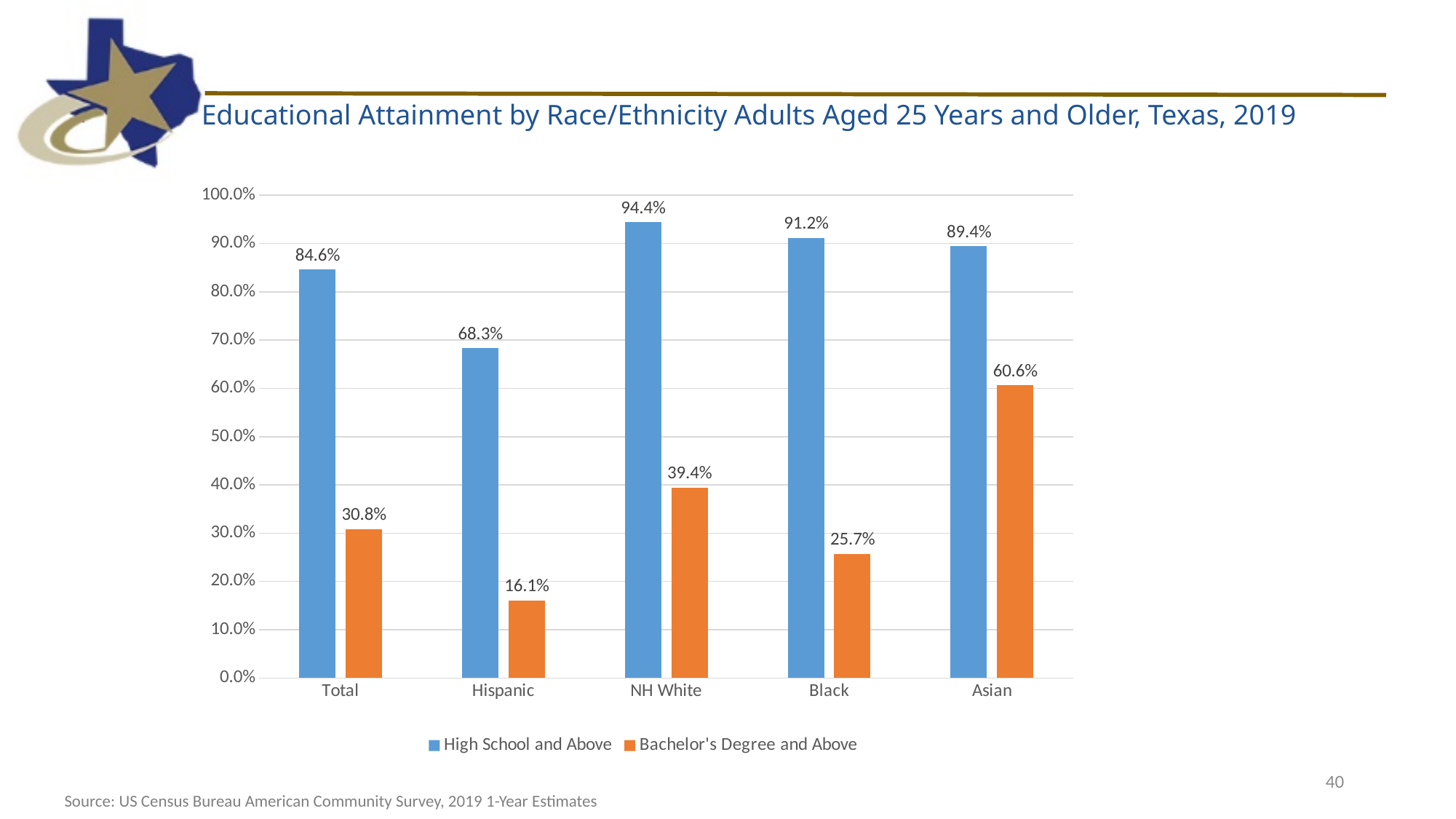
How many series does the legend list? 2 What is the difference between the High School and Above and Bachelor's Degree and Above values for NH White? 55.0% What is the High School and Above value for Hispanic adults? 68.3% Which category has the highest High School and Above value? NH White Which category has the lowest Bachelor's Degree and Above value? Hispanic What kind of chart is shown on the slide? Bar chart What is the Bachelor's Degree and Above value for Asian adults? 60.6% What colour are the Bachelor's Degree and Above bars? Orange How many race/ethnicity categories are shown on the x axis? 5 Which is larger: the Bachelor's Degree and Above value for Total or for NH White? NH White What is the difference between the High School and Above values for Black and Asian? 1.8% What is the Bachelor's Degree and Above value for Black adults? 25.7%